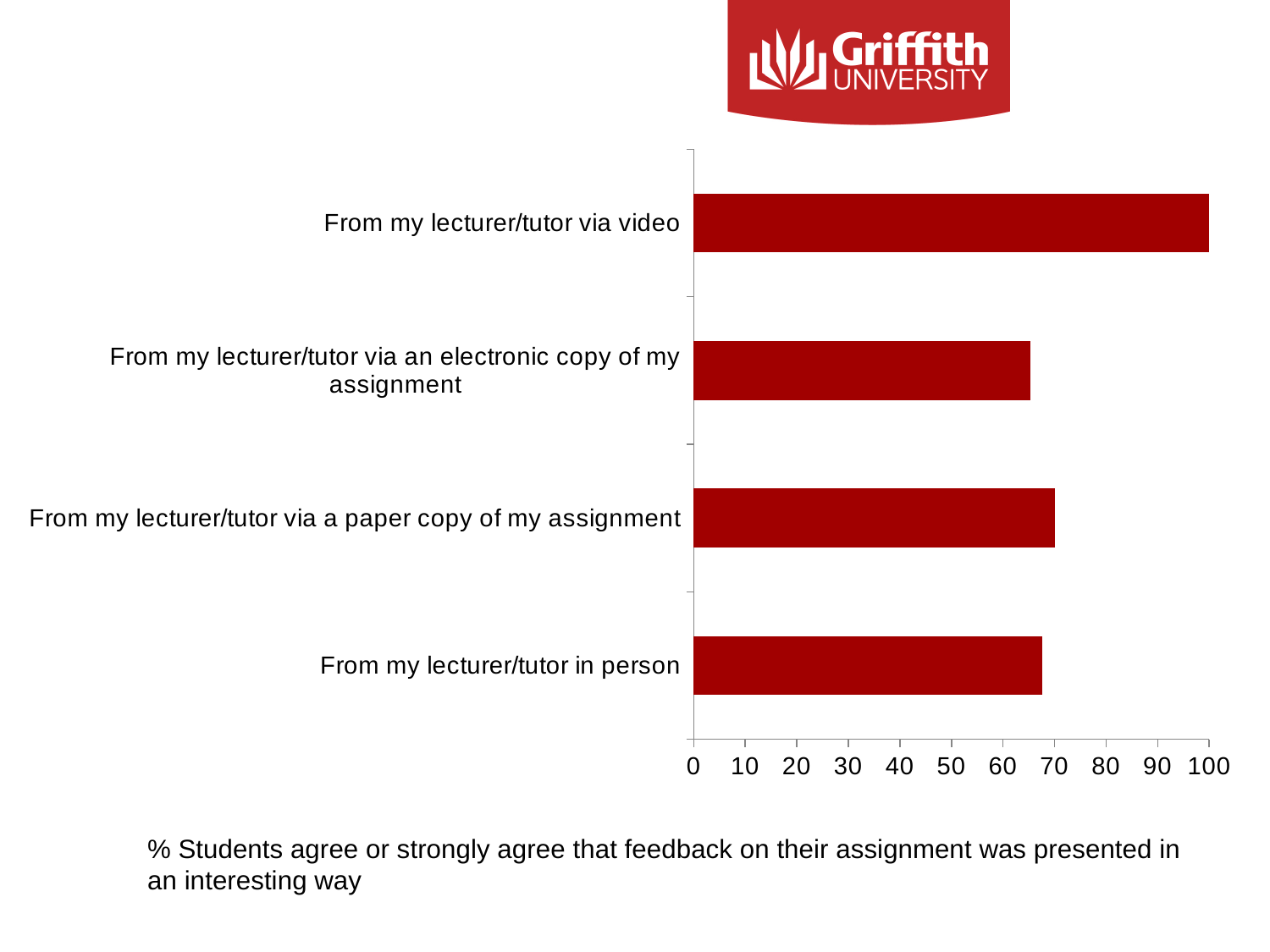
Is the value for 'From my lecturer/tutor via an electronic copy of my assignment' greater or less than 70? less Is the value for 'From my lecturer/tutor via a paper copy of my assignment' greater or less than 60? greater What is the highest value shown on the horizontal axis? 100 What kind of chart is shown on the slide? bar chart What is the value for 'From my lecturer/tutor via video'? 100 Is the value for 'From my lecturer/tutor in person' greater or less than 80? less According to the caption below the chart, what do the values represent? % Students agree or strongly agree that feedback on their assignment was presented in an interesting way Which is larger: the value for 'From my lecturer/tutor via video' or the value for 'From my lecturer/tutor in person'? From my lecturer/tutor via video Which category has the highest value? From my lecturer/tutor via video How many categories are shown in the chart? 4